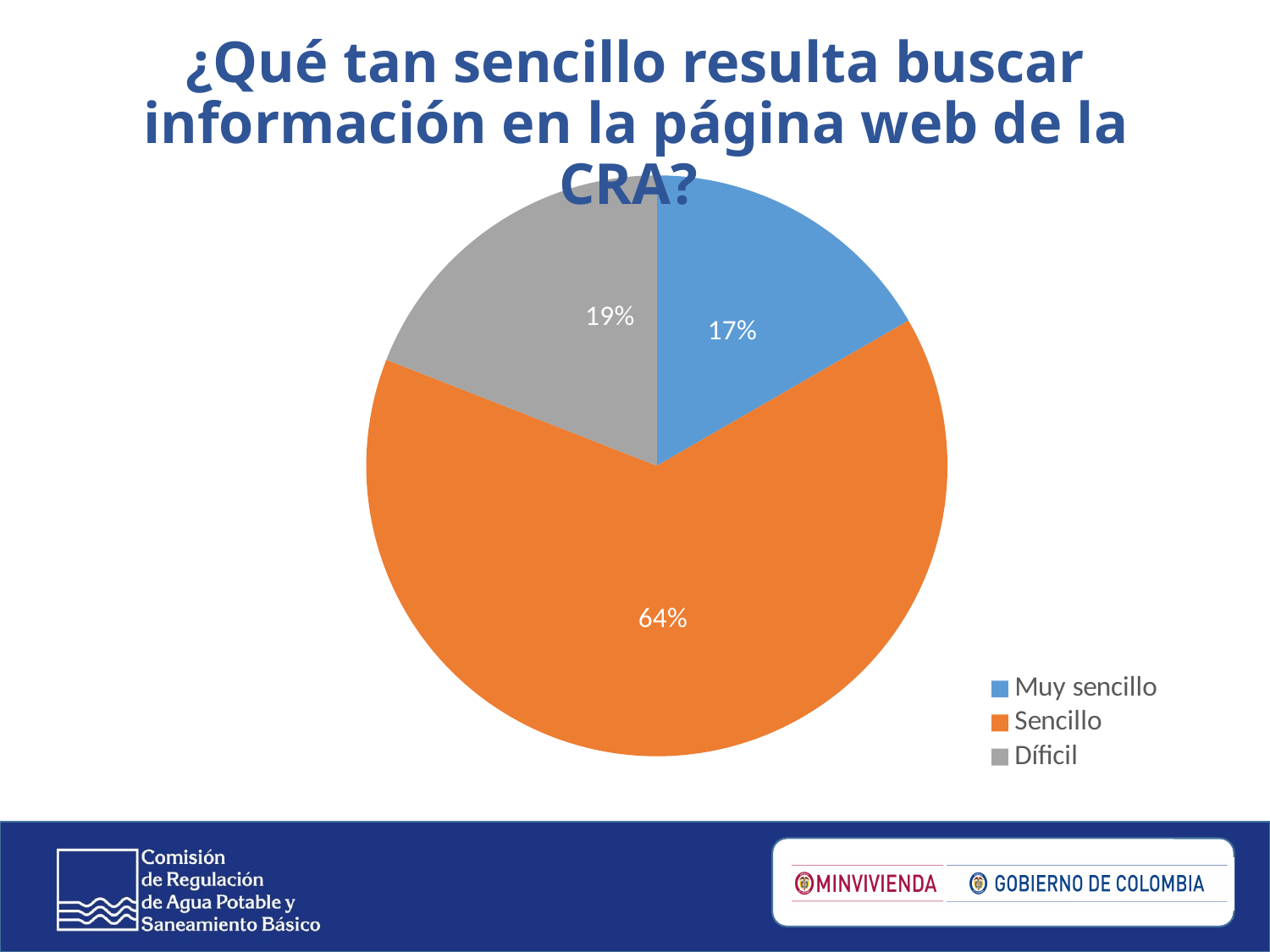
Which category has the smallest slice of the pie? Muy sencillo What is the difference in percentage points between "Sencillo" and "Díficil"? 45 Which is larger, the slice for "Muy sencillo" or the slice for "Díficil"? Díficil What share of the pie does "Muy sencillo" represent? 17% What share of the pie does "Díficil" represent? 19% Which category is shown in grey? Díficil How many categories does the legend list? 3 What is the difference in percentage points between "Díficil" and "Muy sencillo"? 2 What share of the pie does "Sencillo" represent? 64% Which category has the largest slice of the pie? Sencillo What colour is the slice for "Sencillo"? orange What kind of chart is shown on the slide? pie chart